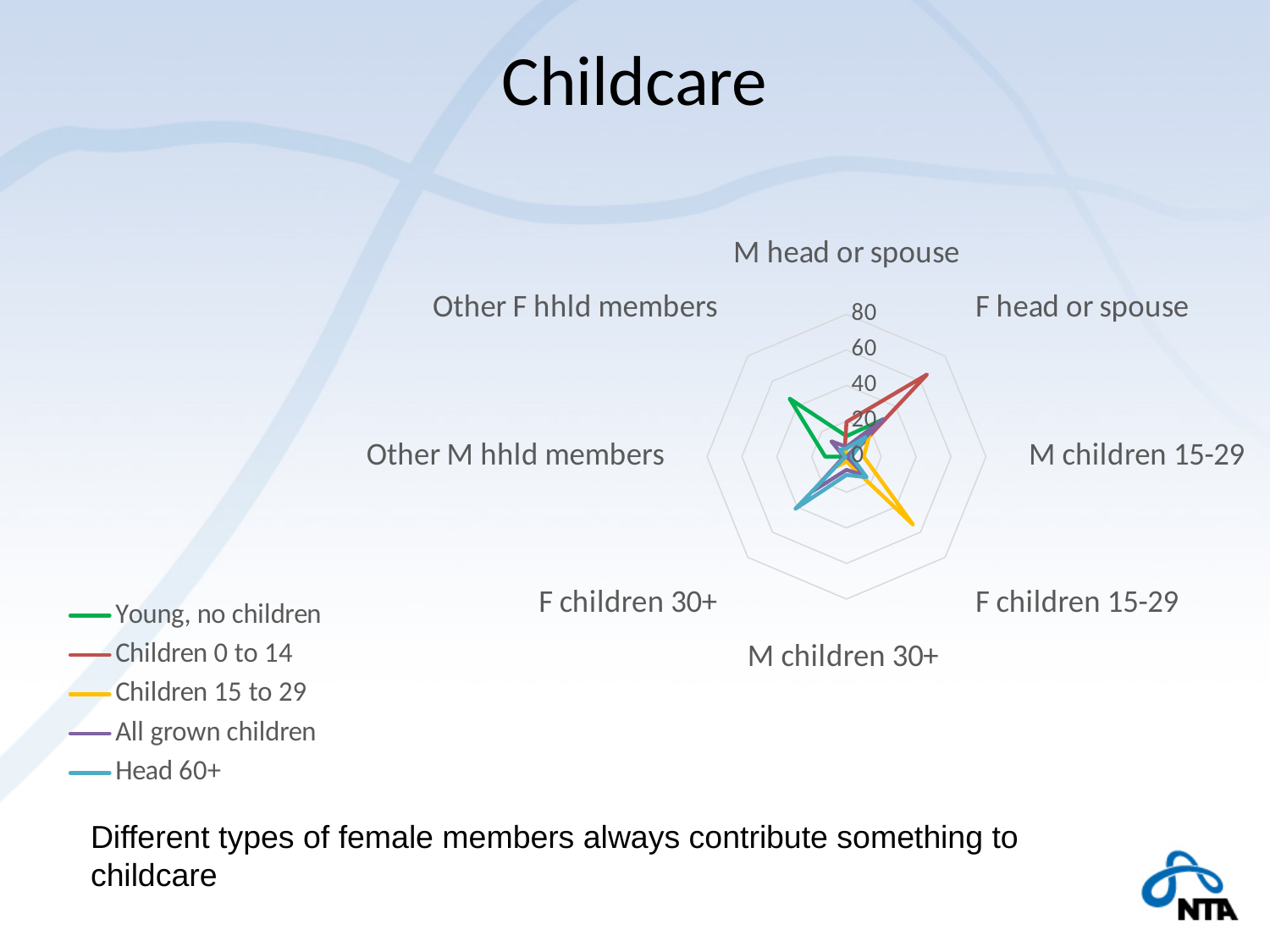
For the Head 60+ series, which category has the highest value? F children 30+ How many series does the legend list? 5 How many categories (axes) does the radar chart have? 8 Is the value for Head 60+ at F children 30+ greater or less than 20? greater Is the value for Children 0 to 14 at F head or spouse greater or less than 40? greater Is the value for Children 15 to 29 at F children 15-29 greater or less than 40? greater For the Children 0 to 14 series, which category has the highest value? F head or spouse What kind of chart is shown on the slide? Radar chart For the Young, no children series, which category has the highest value? Other F hhld members What is the title of the chart? Childcare What is the highest value shown on the radial axis? 80